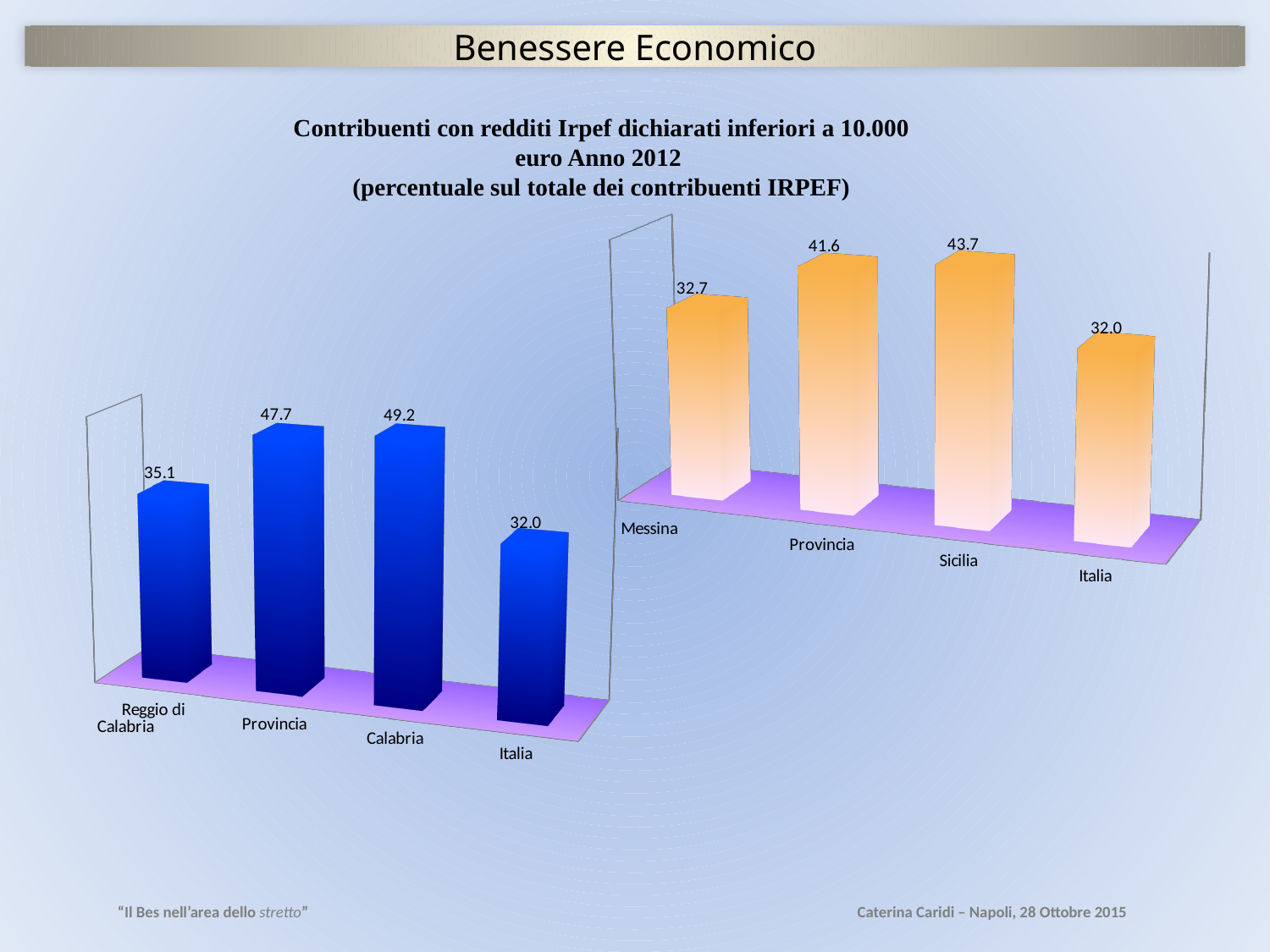
What year do the charts refer to, according to the title? 2012 In the right (orange) chart, what is the difference between the values for Sicilia and Messina? 11.0 In the left (blue) chart, which category has the highest value? Calabria In the right (orange) chart, what is the value for Messina? 32.7 How many categories are shown in the left (blue) chart? 4 What kind of chart is the right (orange) chart? Bar chart In the left (blue) chart, what is the value for Reggio di Calabria? 35.1 In the right (orange) chart, what is the value for Sicilia? 43.7 In the left (blue) chart, what is the difference between the values for Calabria and Italia? 17.2 In the right (orange) chart, which category has the lowest value? Italia In the left (blue) chart, what is the value for Calabria? 49.2 In the right (orange) chart, which is larger: the value for Provincia or the value for Messina? Provincia